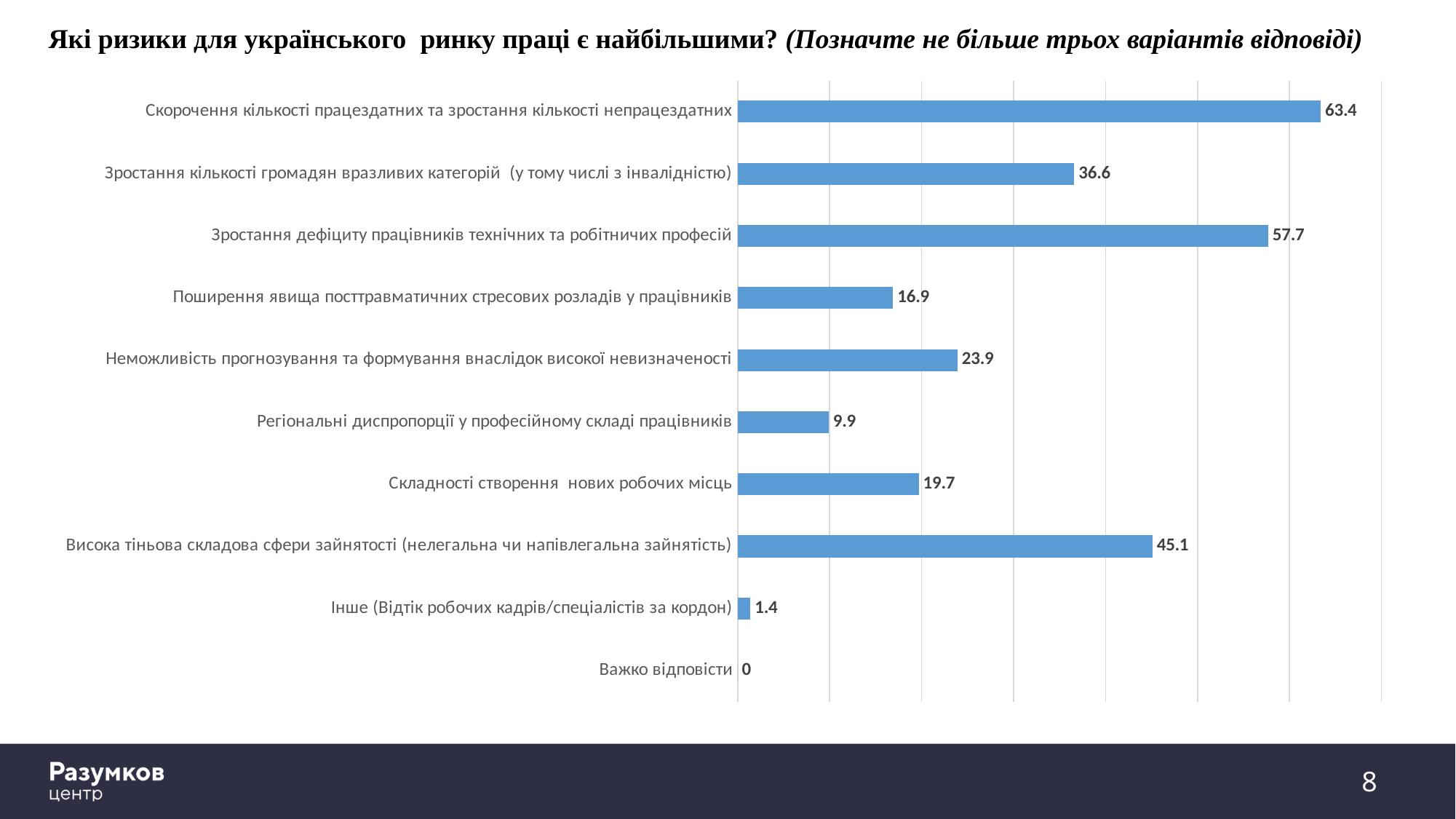
What is the value for "Скорочення кількості працездатних та зростання кількості непрацездатних"? 63.4 What is the value for "Інше (Відтік робочих кадрів/спеціалістів за кордон)"? 1.4 What is the value for "Висока тіньова складова сфери зайнятості (нелегальна чи напівлегальна зайнятість)"? 45.1 Which is larger: the value for "Складності створення нових робочих місць" or for "Поширення явища посттравматичних стресових розладів у працівників"? Складності створення нових робочих місць Which category has the lowest value? Важко відповісти Which category has the highest value? Скорочення кількості працездатних та зростання кількості непрацездатних What type of chart is shown on the slide? Bar chart How many categories are shown in the chart? 10 What is the difference between the values for "Скорочення кількості працездатних та зростання кількості непрацездатних" and "Зростання дефіциту працівників технічних та робітничих професій"? 5.7 What is the value for "Регіональні диспропорції у професійному складі працівників"? 9.9 What colour are the bars in the chart? Blue What is the difference between the values for "Висока тіньова складова сфери зайнятості" and "Зростання кількості громадян вразливих категорій"? 8.5